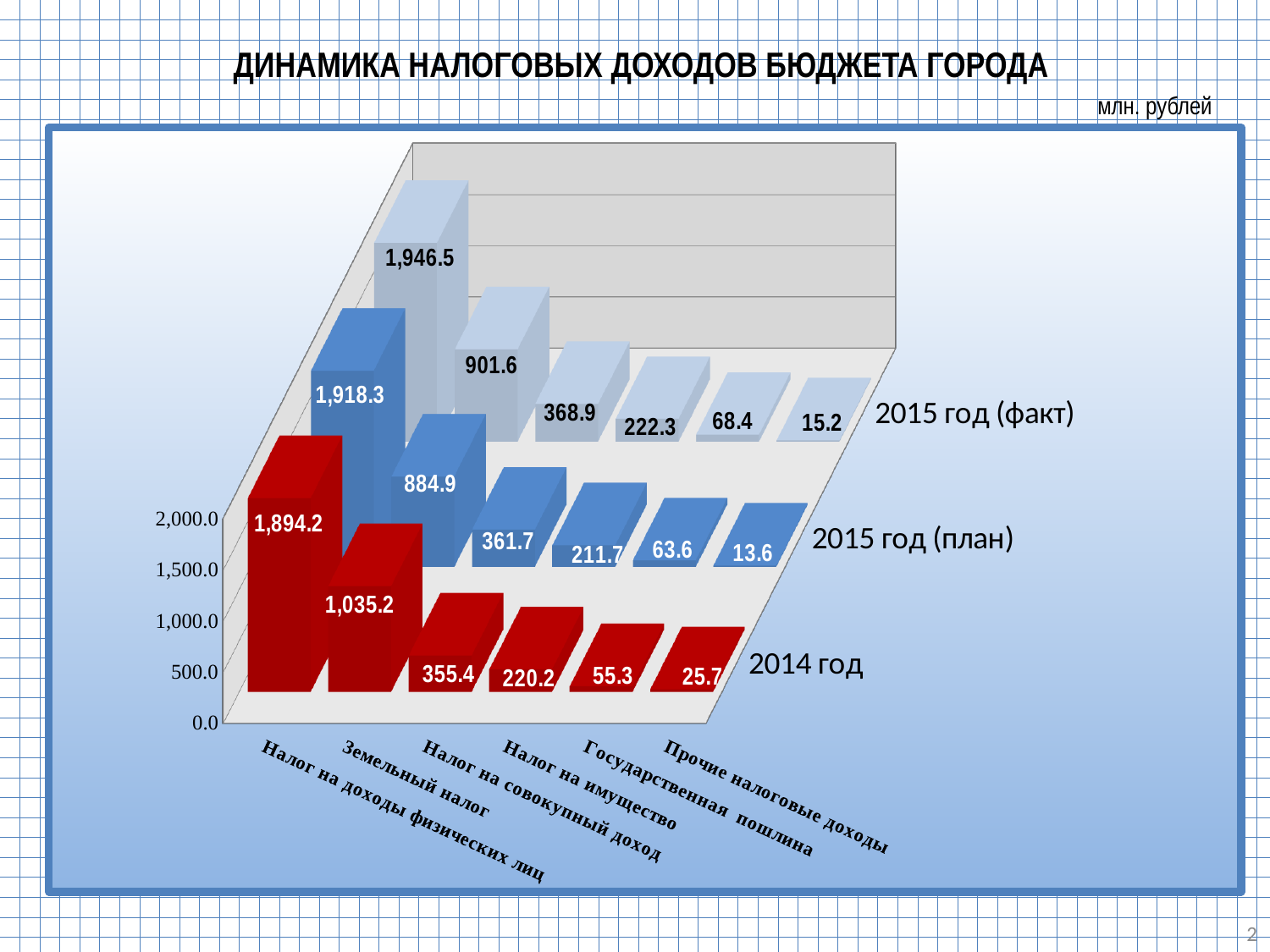
What is the value for Прочие налоговые доходы in the 2015 год (факт) series? 15.2 What type of chart is shown on the slide? Bar chart How many data series does the chart show? 3 What is the difference between the 2015 год (факт) and 2015 год (план) values for Земельный налог? 16.7 What unit is indicated above the chart? млн. рублей What is the value for Налог на доходы физических лиц in the 2015 год (факт) series? 1,946.5 Which is larger for Государственная пошлина: the 2014 год value or the 2015 год (факт) value? 2015 год (факт) Which category has the lowest value in the 2015 год (план) series? Прочие налоговые доходы What is the value for Земельный налог in the 2014 год series? 1,035.2 How many categories are shown on the x axis? 6 What is the value for Налог на имущество in the 2015 год (план) series? 211.7 Which category has the highest value in the 2014 год series? Налог на доходы физических лиц